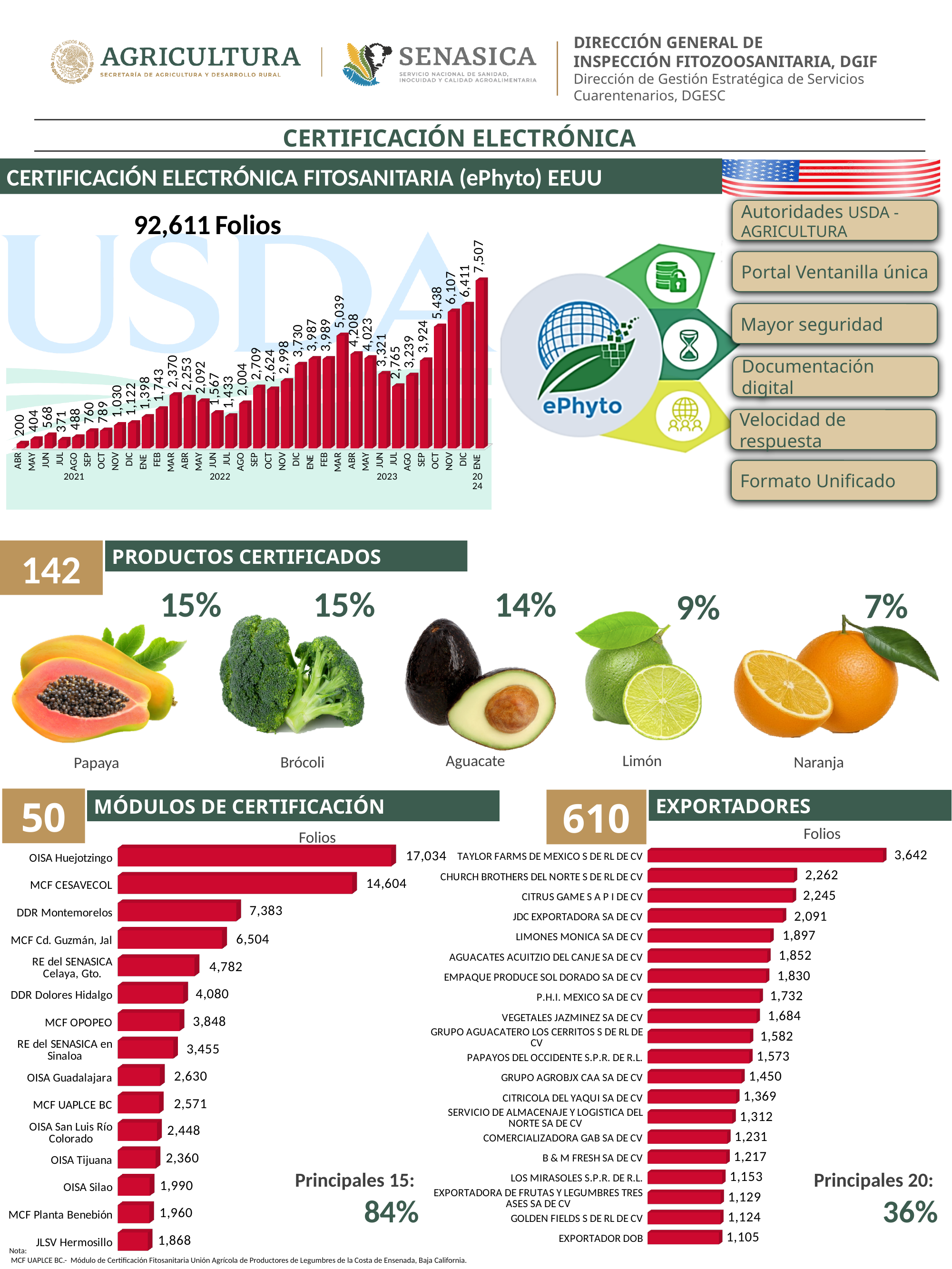
What kind of chart is the monthly folios chart at the top of the slide? Bar chart In the Módulos de Certificación chart, what is the difference between OISA Huejotzingo and MCF CESAVECOL? 2,430 In the monthly folios bar chart at the top, what is the value for MAR 2023? 5,039 In the monthly folios bar chart at the top, what is the value for ENE 2024? 7,507 In the Exportadores chart, which is larger: CITRUS GAME S A P I DE CV or JDC EXPORTADORA SA DE CV? CITRUS GAME S A P I DE CV In the Módulos de Certificación chart, what is the value for OISA Huejotzingo? 17,034 In the Módulos de Certificación chart, how many modules are listed? 15 In the monthly folios bar chart at the top, which month has the lowest value? ABR 2021 In the monthly folios bar chart at the top, how many monthly bars are plotted? 34 In the Exportadores chart, which exporter has the highest value? TAYLOR FARMS DE MEXICO S DE RL DE CV In the Exportadores chart, what is the value for EXPORTADOR DOB? 1,105 In the monthly folios bar chart at the top, which month has the highest value? ENE 2024